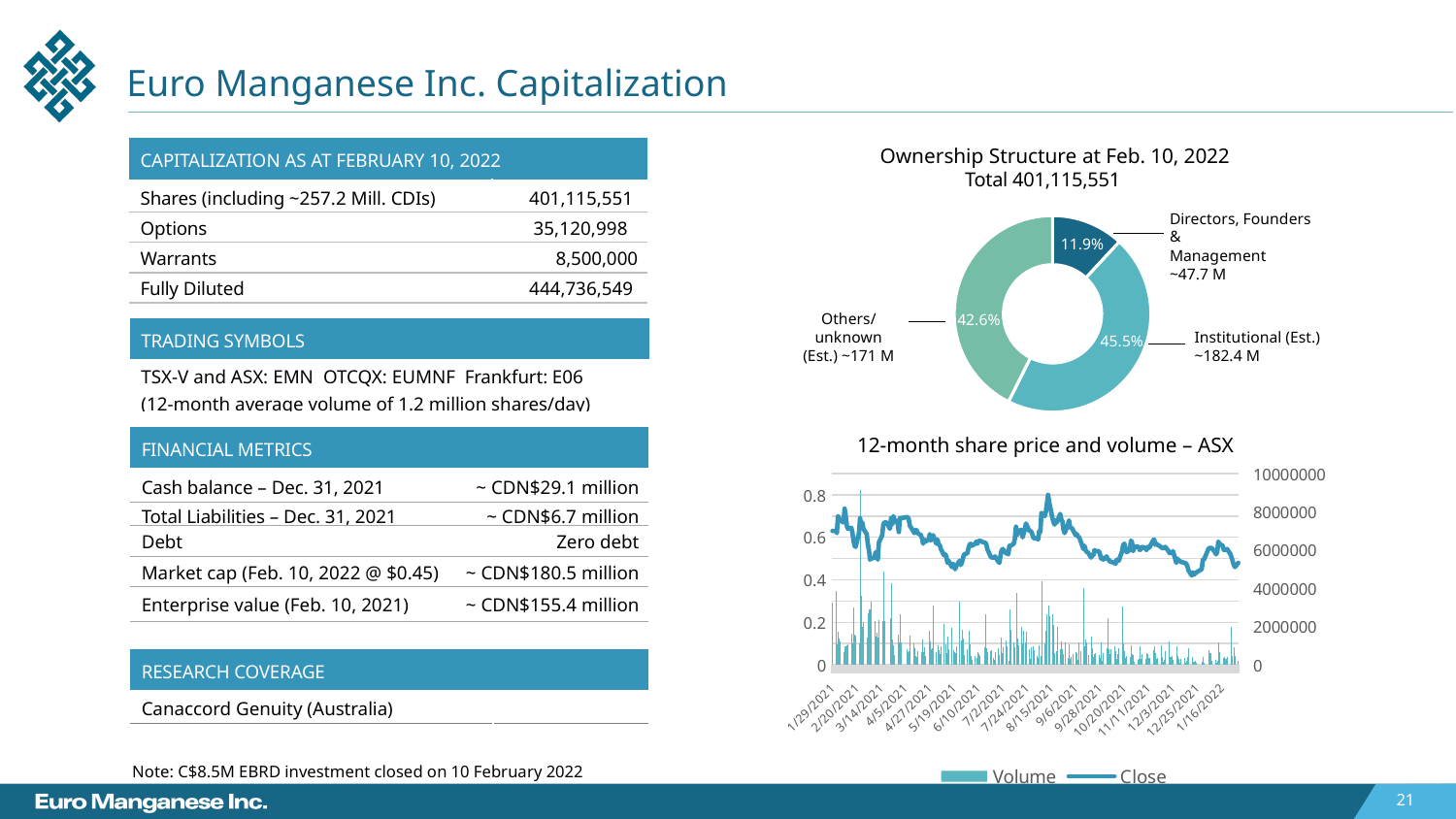
In the 12-month share price and volume – ASX chart, how many series does the legend list? 2 In the Ownership Structure chart, which group holds the smallest share? Directors, Founders & Management In the Ownership Structure chart, which group holds the largest share? Institutional (Est.) In the Ownership Structure chart, how many ownership groups are shown? 3 In the 12-month share price and volume – ASX chart, what is the maximum value shown on the right-hand (volume) axis? 10000000 What type of chart is the Ownership Structure chart? Donut (pie) chart In the Ownership Structure chart, approximately how many shares are held by Institutional (Est.) holders, as labelled? ~182.4 M In the Ownership Structure chart, what percentage is attributed to Others/unknown (Est.)? 42.6% In the Ownership Structure chart, what is the difference in percentage points between the Institutional (Est.) share and the Others/unknown (Est.) share? 2.9 percentage points In the Ownership Structure chart, what percentage is attributed to Directors, Founders & Management? 11.9% In the Ownership Structure chart, what share of ownership is held by Institutional (Est.) holders? 45.5% In the 12-month share price and volume – ASX chart, what are the two series named in the legend? Volume and Close